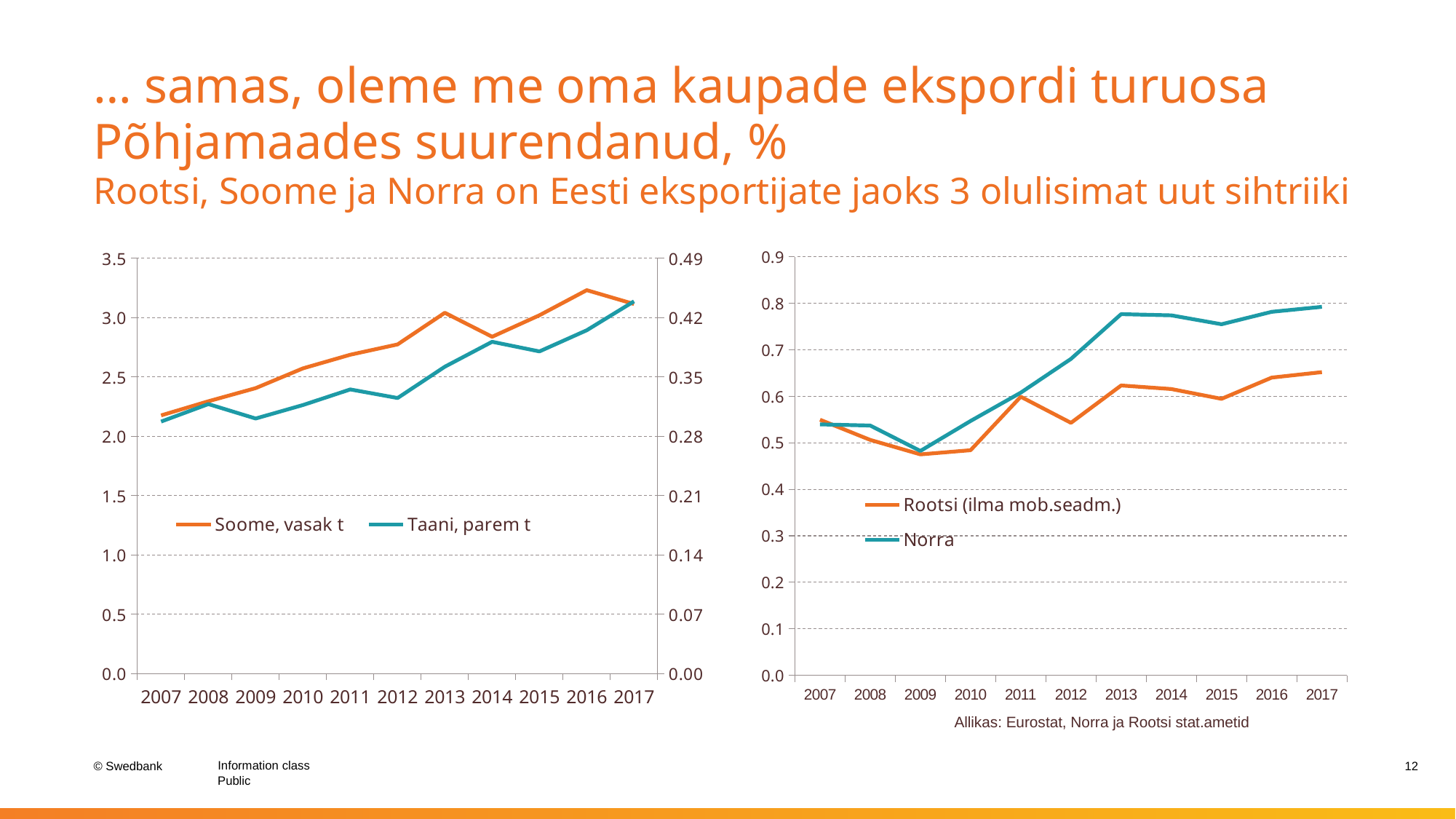
What is the name of the second series in the legend of the left chart? Taani, parem t In the right chart, is the value for Rootsi (ilma mob.seadm.) in 2009 greater or less than 0.5? less How many series does the legend of the right chart list? 2 In the right chart, which series has the larger value in 2015, Rootsi (ilma mob.seadm.) or Norra? Norra In the right chart, which year has the lowest value for Norra? 2009 In the left chart, is the value for Taani, parem t in 2017 greater or less than 0.42? greater In the left chart, which year has the lowest value for Soome, vasak t? 2007 In the left chart, which year has the highest value for Soome, vasak t? 2016 In the right chart, does the Norra series generally rise or fall from 2009 to 2017? rise How many years are shown on the x axis of the left chart? 11 In the left chart, is the value for Soome, vasak t in 2017 greater or less than 3.0? greater What kind of chart is the left chart on the slide? line chart